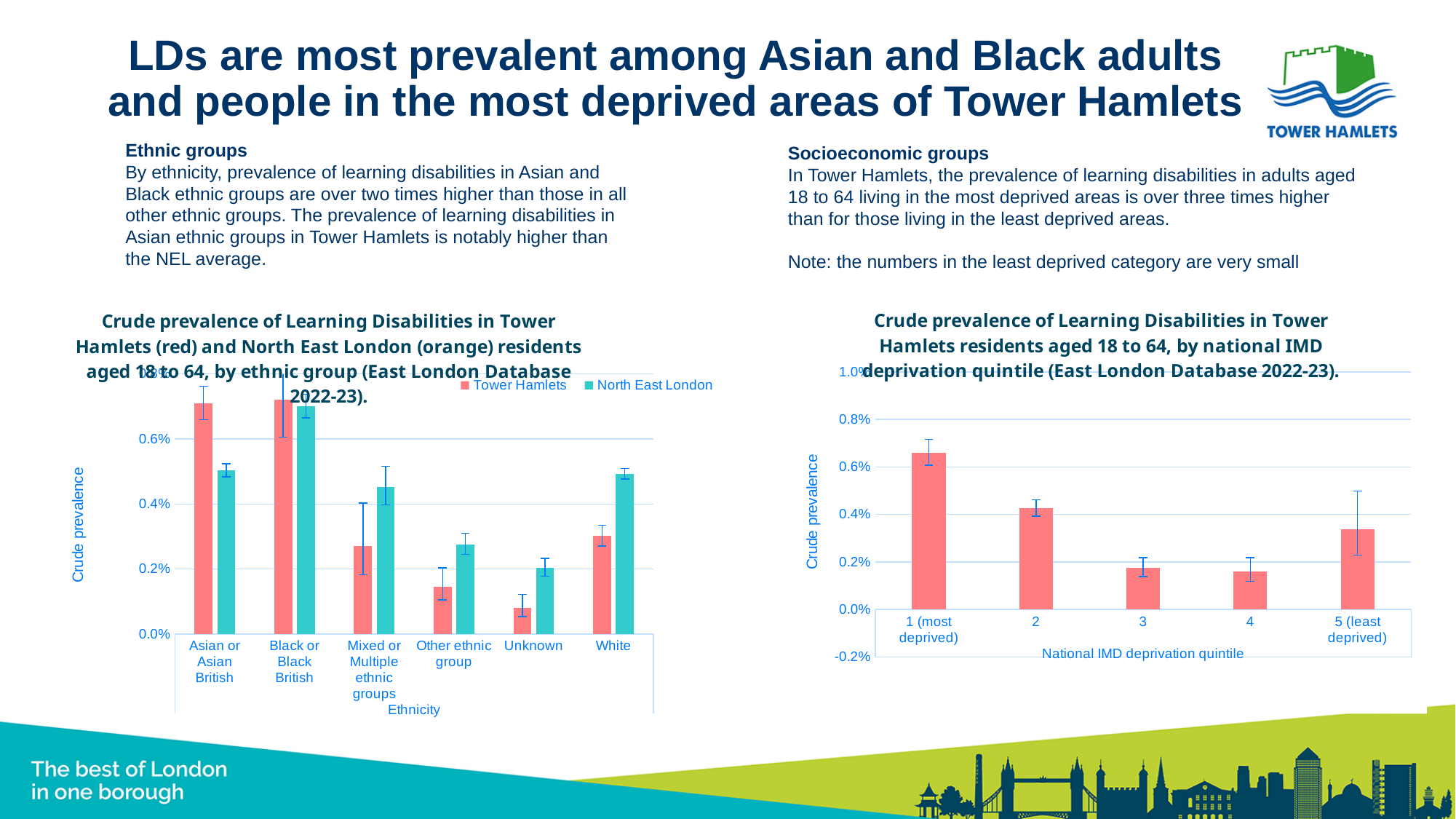
On the left chart (by ethnic group), which is larger for Asian or Asian British: the Tower Hamlets value or the North East London value? Tower Hamlets On the left chart (by ethnic group), which is larger for White: the Tower Hamlets value or the North East London value? North East London On the left chart (by ethnic group), which ethnic group has the highest North East London value? Black or Black British On the right chart (by IMD deprivation quintile), what kind of chart is it? Bar chart On the right chart (by IMD deprivation quintile), is the value for quintile 5 (least deprived) greater or less than 0.2%? greater On the left chart (by ethnic group), how many series does the legend list? 2 On the right chart (by IMD deprivation quintile), what is the label of the x axis? National IMD deprivation quintile On the left chart (by ethnic group), how many ethnic group categories are shown on the x axis? 6 On the left chart (by ethnic group), is the Tower Hamlets value for White greater or less than 0.4%? less On the right chart (by IMD deprivation quintile), which quintile has the highest crude prevalence? 1 (most deprived) On the left chart (by ethnic group), is the Tower Hamlets value for Asian or Asian British greater or less than 0.6%? greater On the left chart (by ethnic group), which ethnic group has the lowest Tower Hamlets value? Unknown